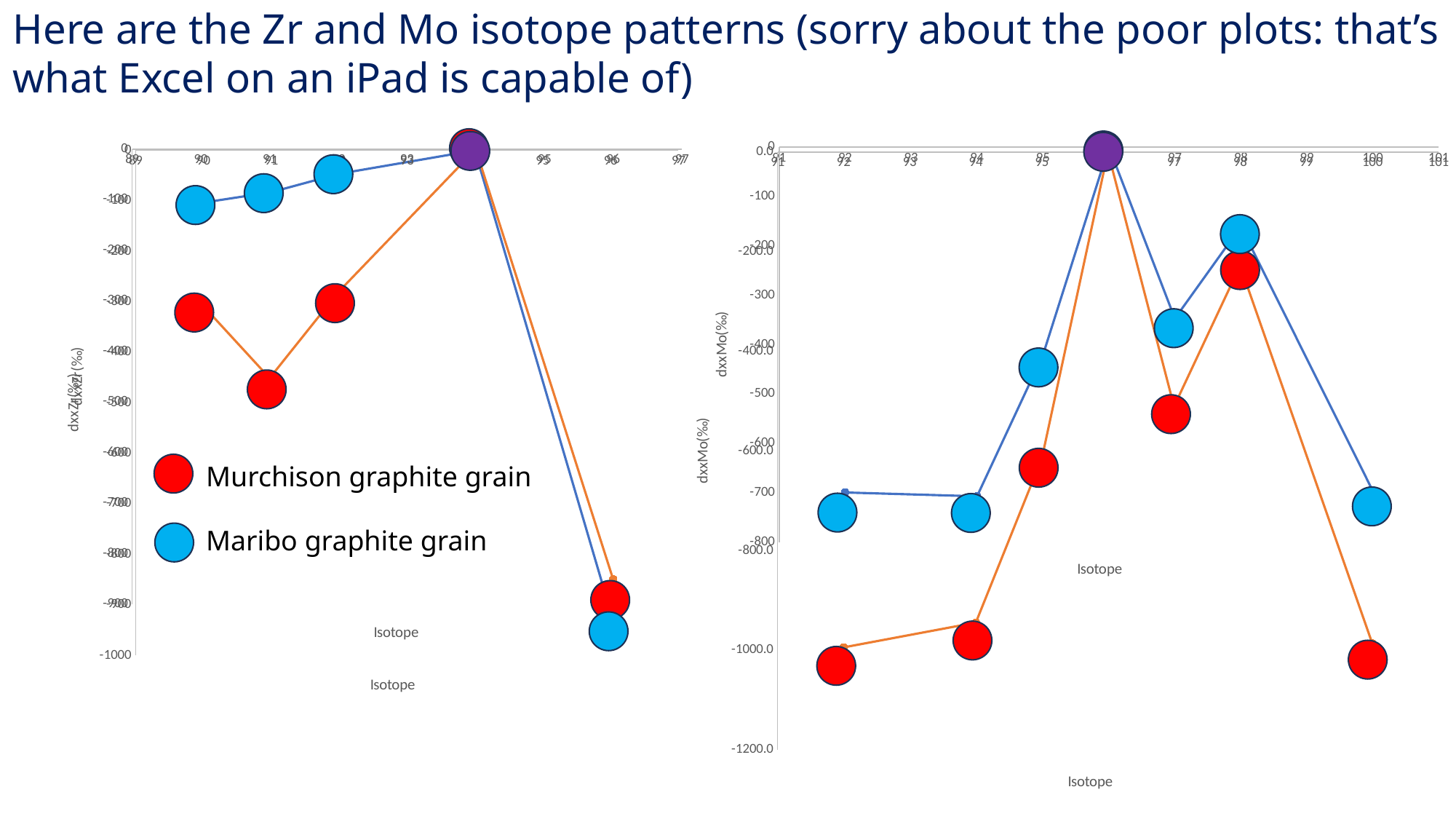
In the left (Zr) chart, at which isotope is the Maribo graphite grain value lowest? 96 In the right (Mo) chart, do the Murchison graphite grain values rise or fall from isotope 98 to isotope 100? fall In the right (Mo) chart, is the Maribo graphite grain value at isotope 98 greater or less than -300? greater In the left (Zr) chart, is the Murchison graphite grain value at isotope 91 greater or less than -400? less In the right (Mo) chart, which series has the larger value at isotope 95, Murchison graphite grain or Maribo graphite grain? Maribo graphite grain What kind of chart is the left (Zr) chart on the slide? line chart In the legend, which colour marks the Murchison graphite grain series? red In the left (Zr) chart, at which isotope do both series reach their highest value? 94 In the left (Zr) chart, is the Maribo graphite grain value at isotope 90 greater or less than -200? greater In the left (Zr) chart, which series has the larger value at isotope 91, Murchison graphite grain or Maribo graphite grain? Maribo graphite grain How many series does the legend on the slide list? 2